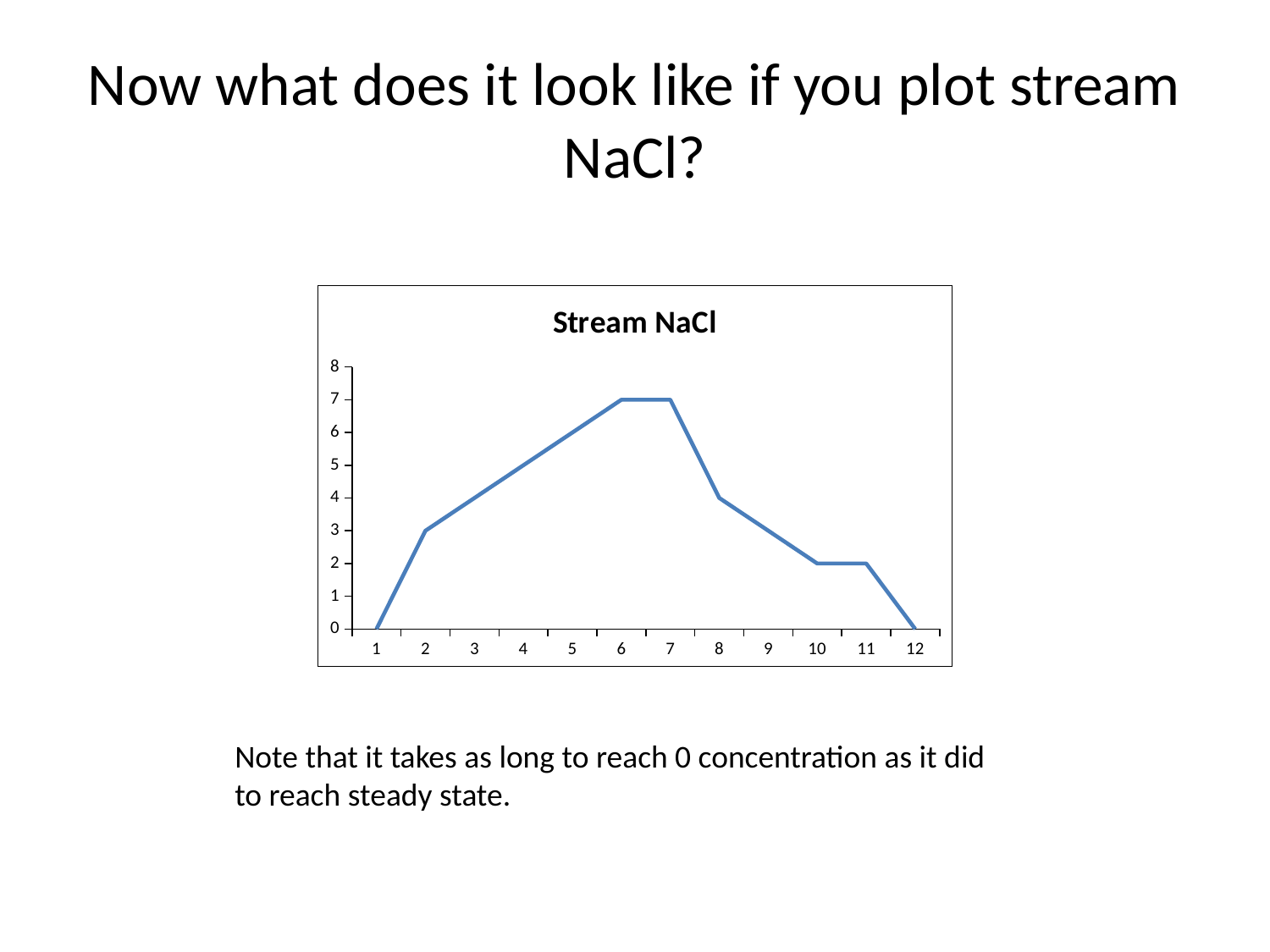
What is the value at x = 2? 3 What is the title of the chart? Stream NaCl What is the highest value reached on the chart? 7 What type of chart is shown on the slide? line chart What is the value at x = 12? 0 Do the values rise or fall from x = 7 to x = 12? fall What is the lowest value on the chart? 0 Which is larger, the value at x = 2 or the value at x = 10? x = 2 How many points are plotted along the x axis? 12 What is the difference between the value at x = 6 and the value at x = 8? 3 What is the value at x = 6? 7 What is the value at x = 8? 4